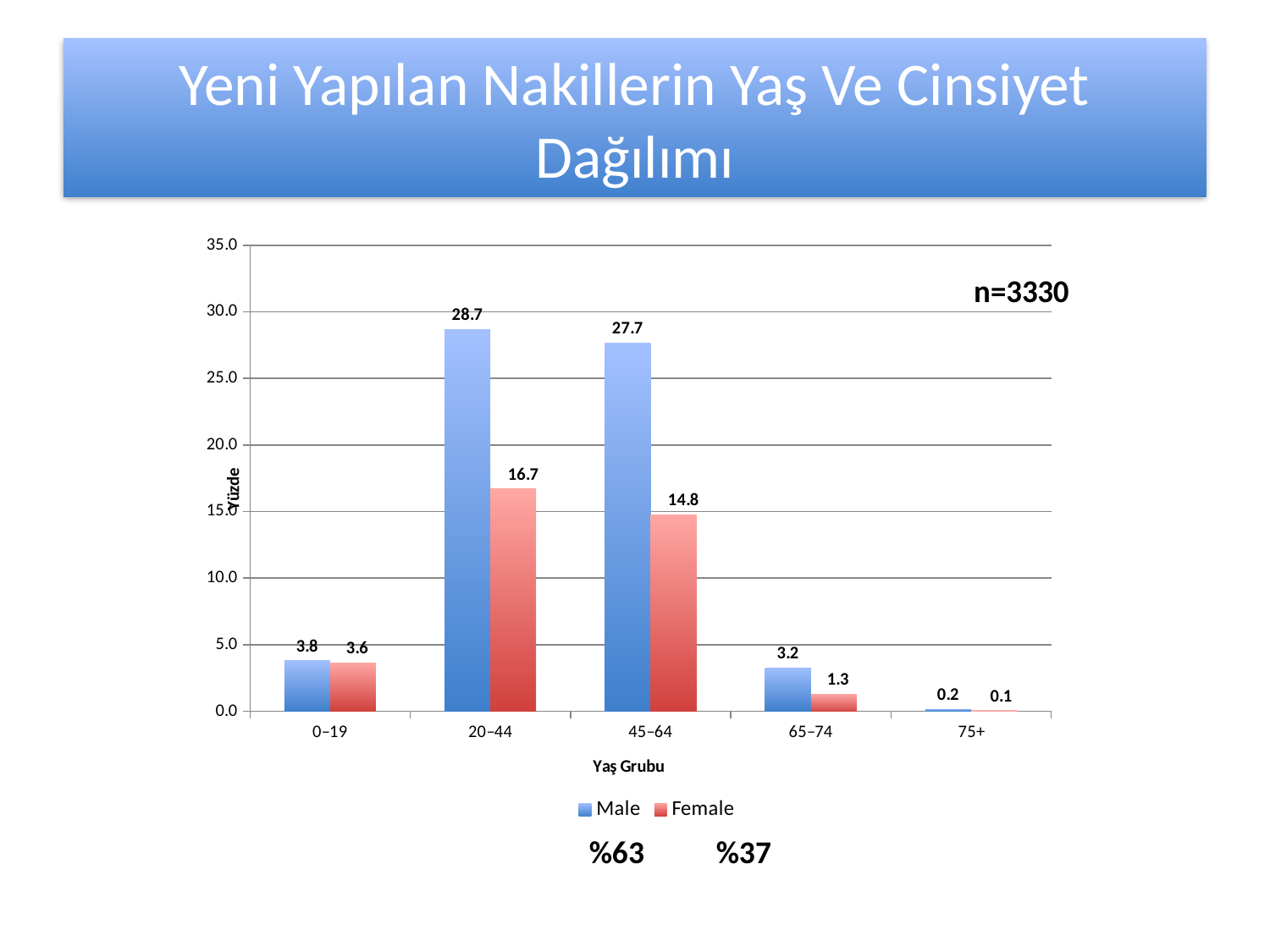
Is the Female value for the 20–44 age group greater or less than 15.0? greater Which age group has the highest Male value? 20–44 What is the sample size (n) shown on the chart? n=3330 How many series does the legend list? 2 Which is larger for the 45–64 age group, the Male value or the Female value? Male What is the difference between the Male and Female values for the 20–44 age group? 12.0 How many age groups are shown on the x axis? 5 What kind of chart is shown on the slide? bar chart What is the Female value for the 45–64 age group? 14.8 What is the Female value for the 65–74 age group? 1.3 What is the Male value for the 20–44 age group? 28.7 Which age group has the lowest Female value? 75+